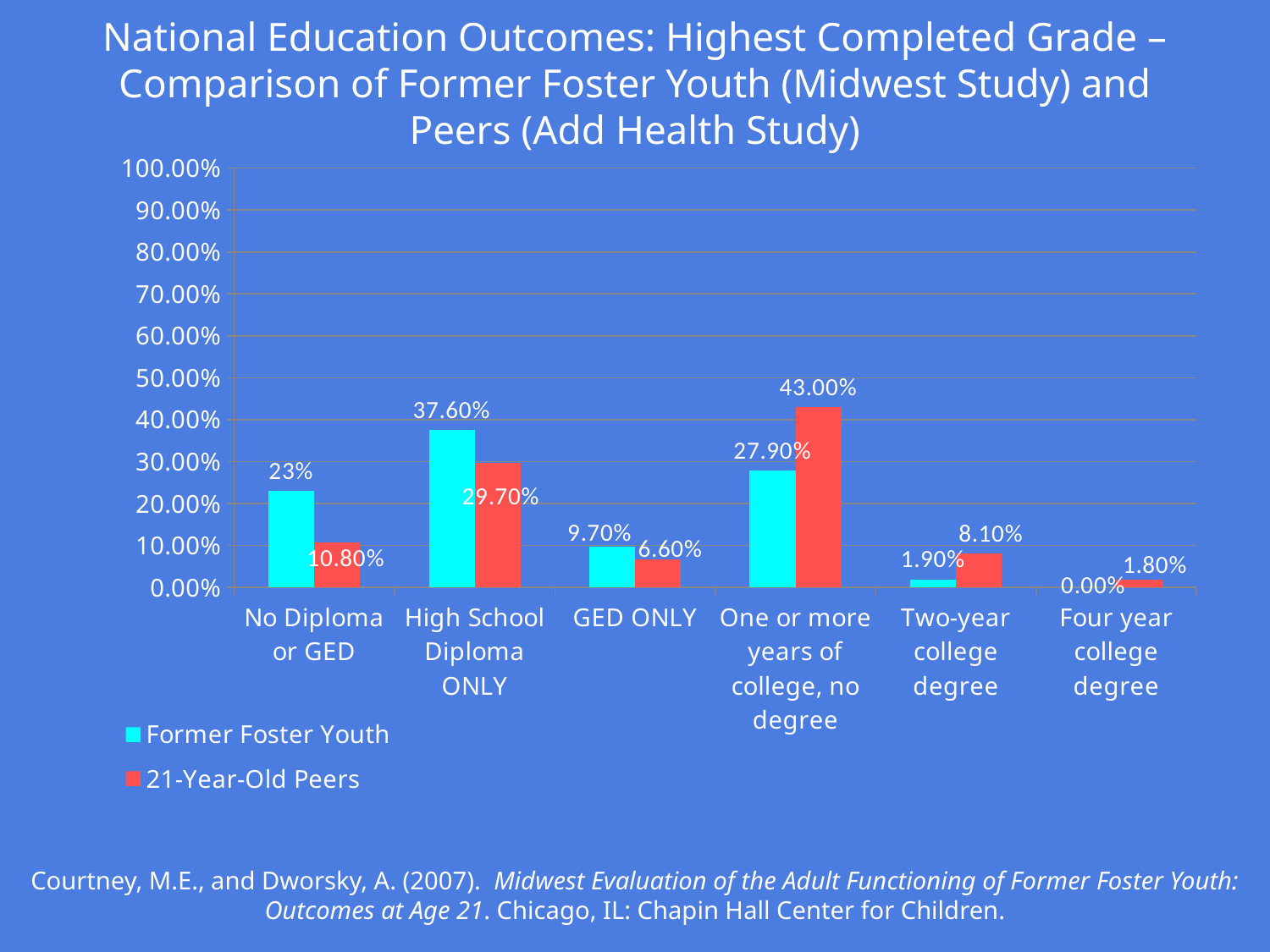
Which category has the highest value for 21-Year-Old Peers? One or more years of college, no degree What is the value for 21-Year-Old Peers in the One or more years of college, no degree category? 43.00% How many categories are shown on the x axis? 6 Is the value for Former Foster Youth in the GED ONLY category greater or less than 10.00%? less Which category has the lowest value for Former Foster Youth? Four year college degree What is the value for Former Foster Youth in the Four year college degree category? 0.00% What kind of chart is shown on the slide? bar chart Which series has the larger value in the Two-year college degree category? 21-Year-Old Peers What is the value for Former Foster Youth in the High School Diploma ONLY category? 37.60% Which colour represents Former Foster Youth in the chart? cyan What is the difference between Former Foster Youth and 21-Year-Old Peers in the No Diploma or GED category? 12.20% How many series does the legend list? 2